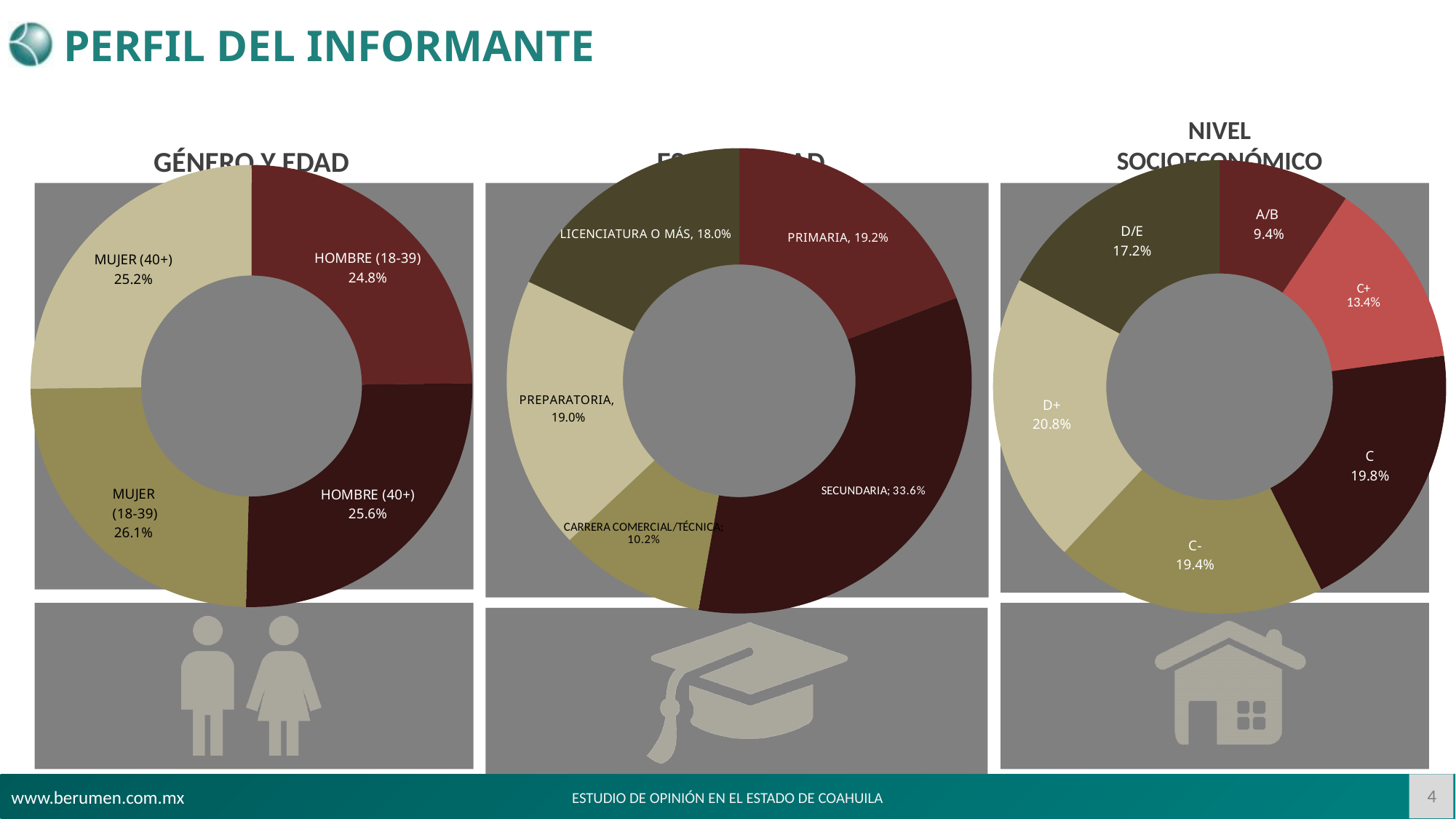
In the NIVEL SOCIOECONÓMICO chart, which category has the largest share? D+ In the GÉNERO Y EDAD chart, which category has the lowest share? HOMBRE (18-39) In the middle chart, what is the value for SECUNDARIA? 33.6% How many categories does the GÉNERO Y EDAD chart show? 4 How many categories does the middle chart show? 5 What kind of chart is the middle chart on the slide? Donut (pie) chart In the middle chart, which category has the smallest share? CARRERA COMERCIAL/TÉCNICA In the GÉNERO Y EDAD chart, what is the difference between HOMBRE (40+) and HOMBRE (18-39)? 0.8% In the NIVEL SOCIOECONÓMICO chart, what is the difference between C and A/B? 10.4% In the middle chart, which is larger: PRIMARIA or LICENCIATURA O MÁS? PRIMARIA In the GÉNERO Y EDAD chart, what is the value for MUJER (18-39)? 26.1% In the NIVEL SOCIOECONÓMICO chart, what is the value for D+? 20.8%